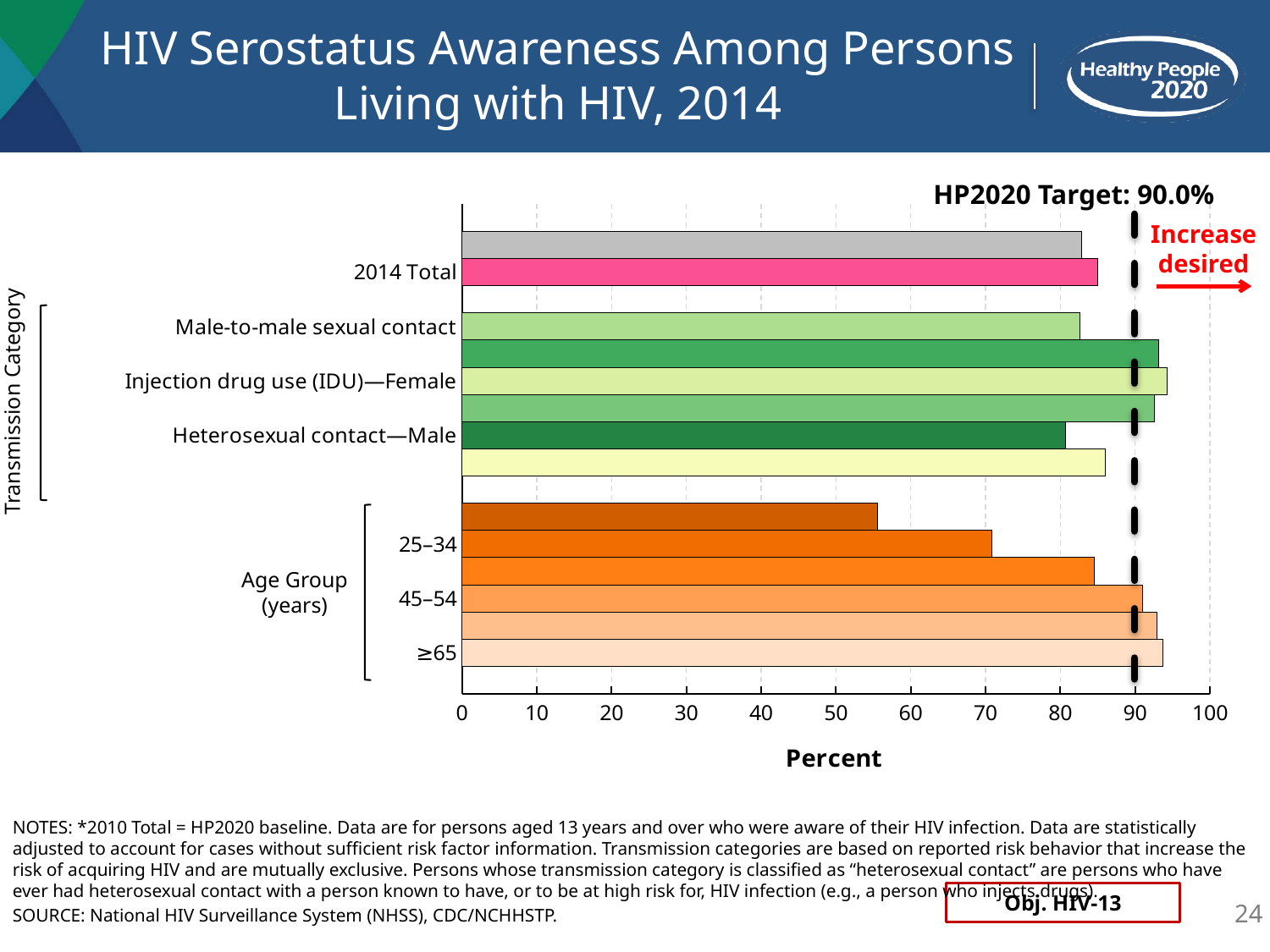
What kind of chart is shown on the slide? bar chart Which is larger, the value for the 25–34 age group or the ≥65 age group? ≥65 What is the HP2020 target value shown on the chart? 90.0% Which is larger, the value for Injection drug use (IDU)—Female or for Male-to-male sexual contact? Injection drug use (IDU)—Female Is the value for Male-to-male sexual contact greater or less than 90? less Is the value for the 25–34 age group greater or less than 80? less How many bars are plotted in the Age Group (years) section of the chart? 6 Is the value for the 45–54 age group greater or less than 80? greater What is the title of the x axis? Percent